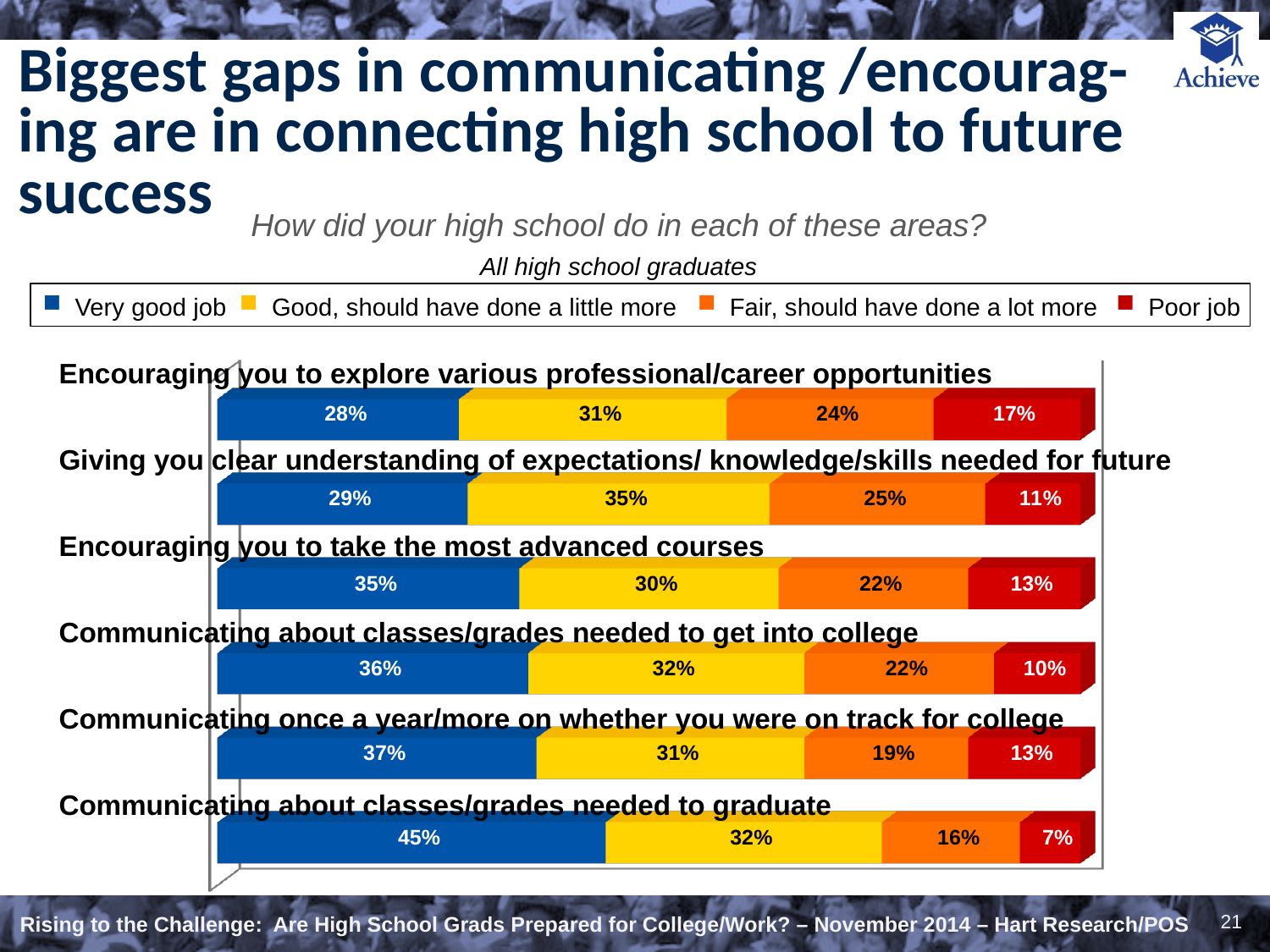
Which legend entry is shown in blue? Very good job How many response categories does the legend list? 4 What type of chart is shown on the slide? Stacked bar chart What is the difference between the "Very good job" percentages for communicating about classes/grades needed to graduate and encouraging you to explore various professional/career opportunities? 17 percentage points What percentage of high school graduates said their school did a "Very good job" of communicating about classes/grades needed to graduate? 45% Which is larger: the "Poor job" value for encouraging you to take the most advanced courses or for communicating about classes/grades needed to get into college? Encouraging you to take the most advanced courses Which area has the highest "Very good job" percentage? Communicating about classes/grades needed to graduate Which area has the lowest "Very good job" percentage? Encouraging you to explore various professional/career opportunities How many areas (categories) are shown in the chart? 6 What is the "Fair, should have done a lot more" value for communicating once a year/more on whether you were on track for college? 19% What is the "Good, should have done a little more" value for giving you clear understanding of expectations/knowledge/skills needed for future? 35% What percentage said their school did a "Poor job" of encouraging them to explore various professional/career opportunities? 17%